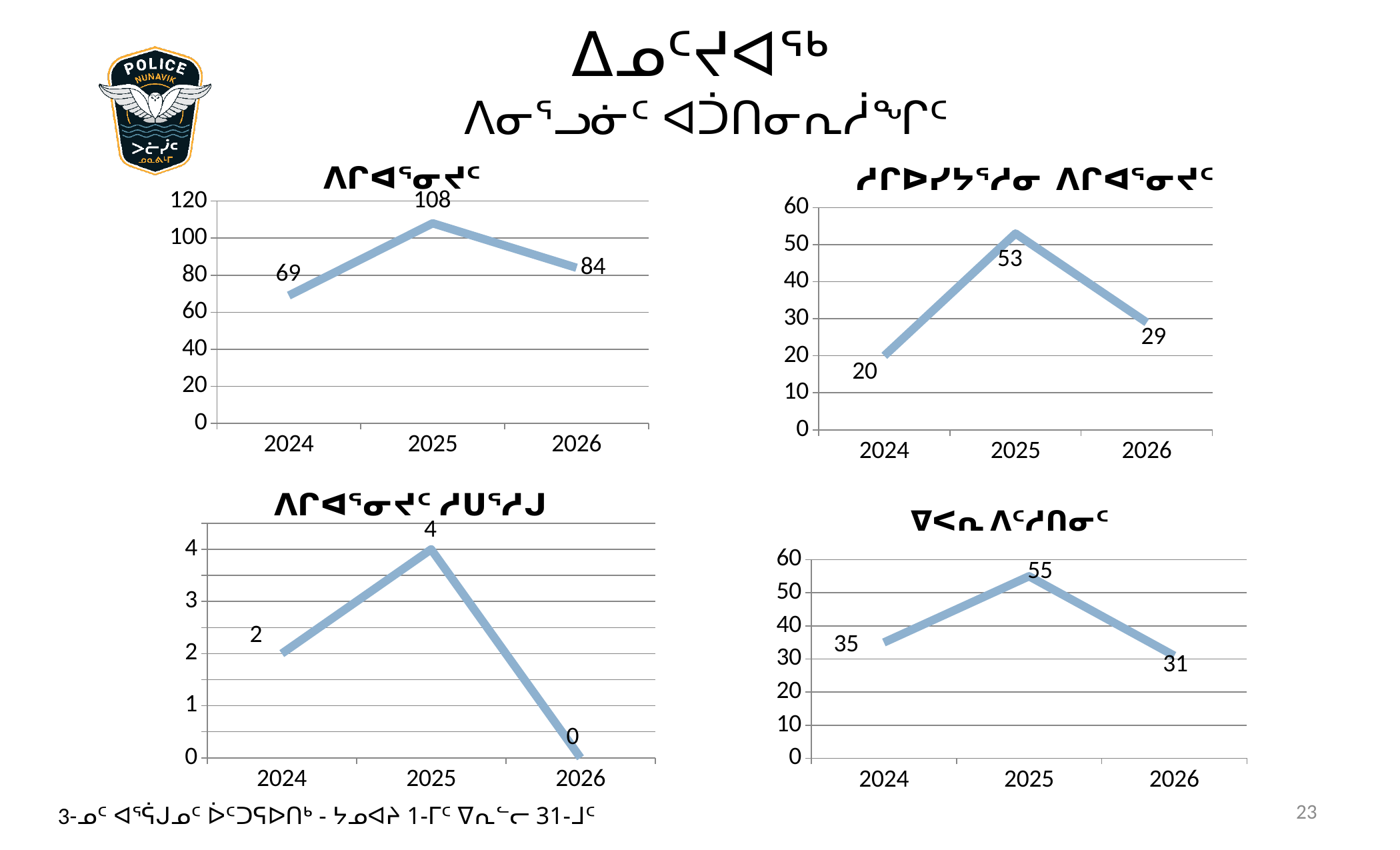
In the top-right chart, which year has the lowest value? 2024 How many data points are plotted in the bottom-right chart? 3 In the bottom-left chart, what is the value for 2026? 0 In the top-right chart, is the value for 2025 greater or less than 50? greater In the top-left chart, what is the difference between the 2025 and 2026 values? 24 In the top-left chart, what is the value for 2025? 108 In the bottom-left chart, which year has the highest value? 2025 In the bottom-right chart, which is larger, the value for 2024 or the value for 2026? 2024 What kind of chart is the top-left chart? line chart In the bottom-right chart, what is the value for 2024? 35 In the top-right chart, what is the value for 2026? 29 In the top-left chart, what is the value for 2024? 69